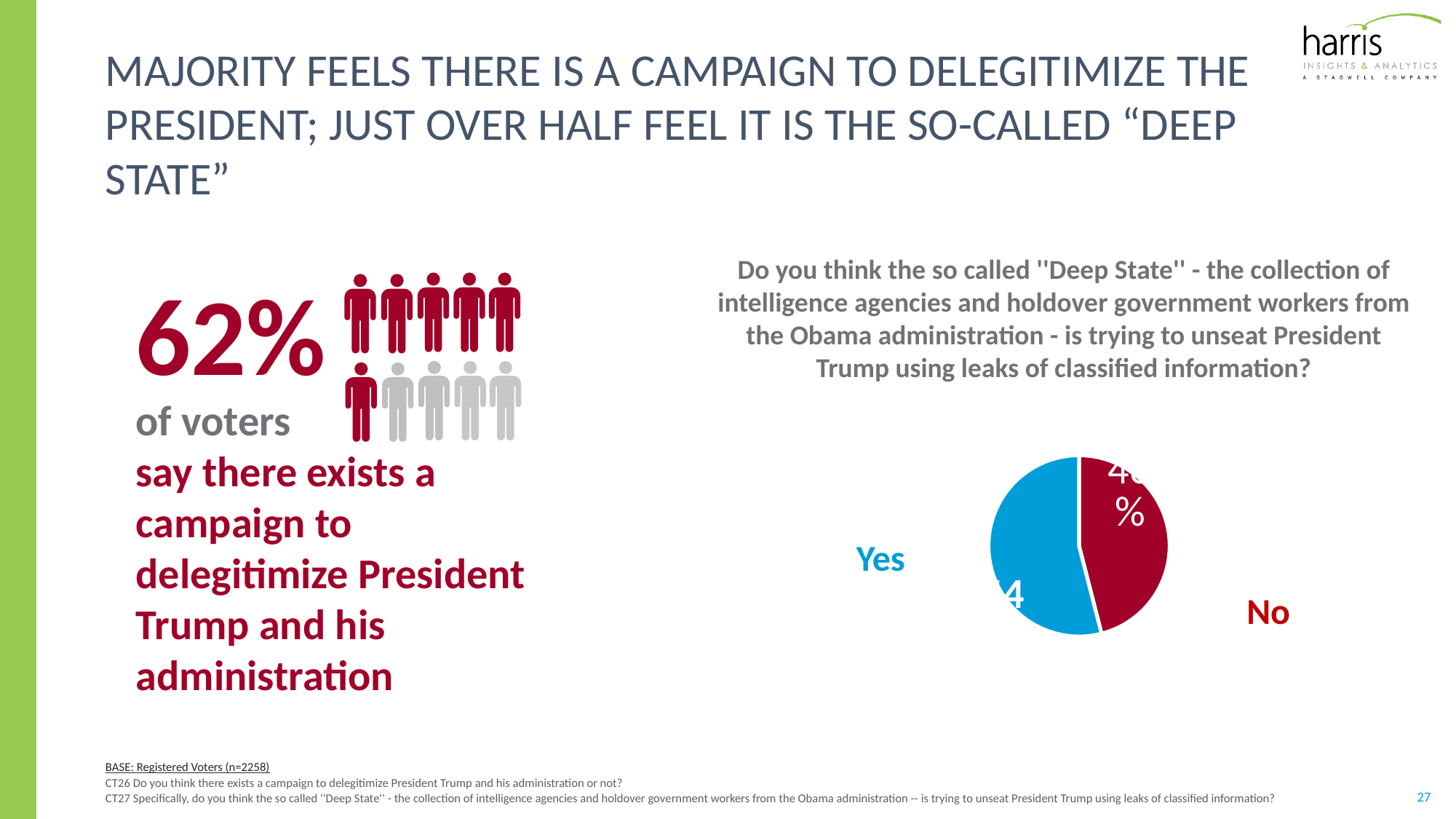
How many person icons are shown in the pictogram on the left? 10 How many of the person icons in the pictogram on the left are coloured red? 6 What are the two response categories shown in the pie chart? Yes and No Which slice of the pie chart is larger, Yes or No? Yes In the pictogram on the left, what percentage of voters say there exists a campaign to delegitimize President Trump and his administration? 62% Which response has the largest share in the pie chart? Yes What kind of chart is used to show responses to the "Deep State" question? Pie chart What colour is the Yes slice in the pie chart? Blue How many slices does the pie chart have? 2 Which response has the smallest share in the pie chart? No